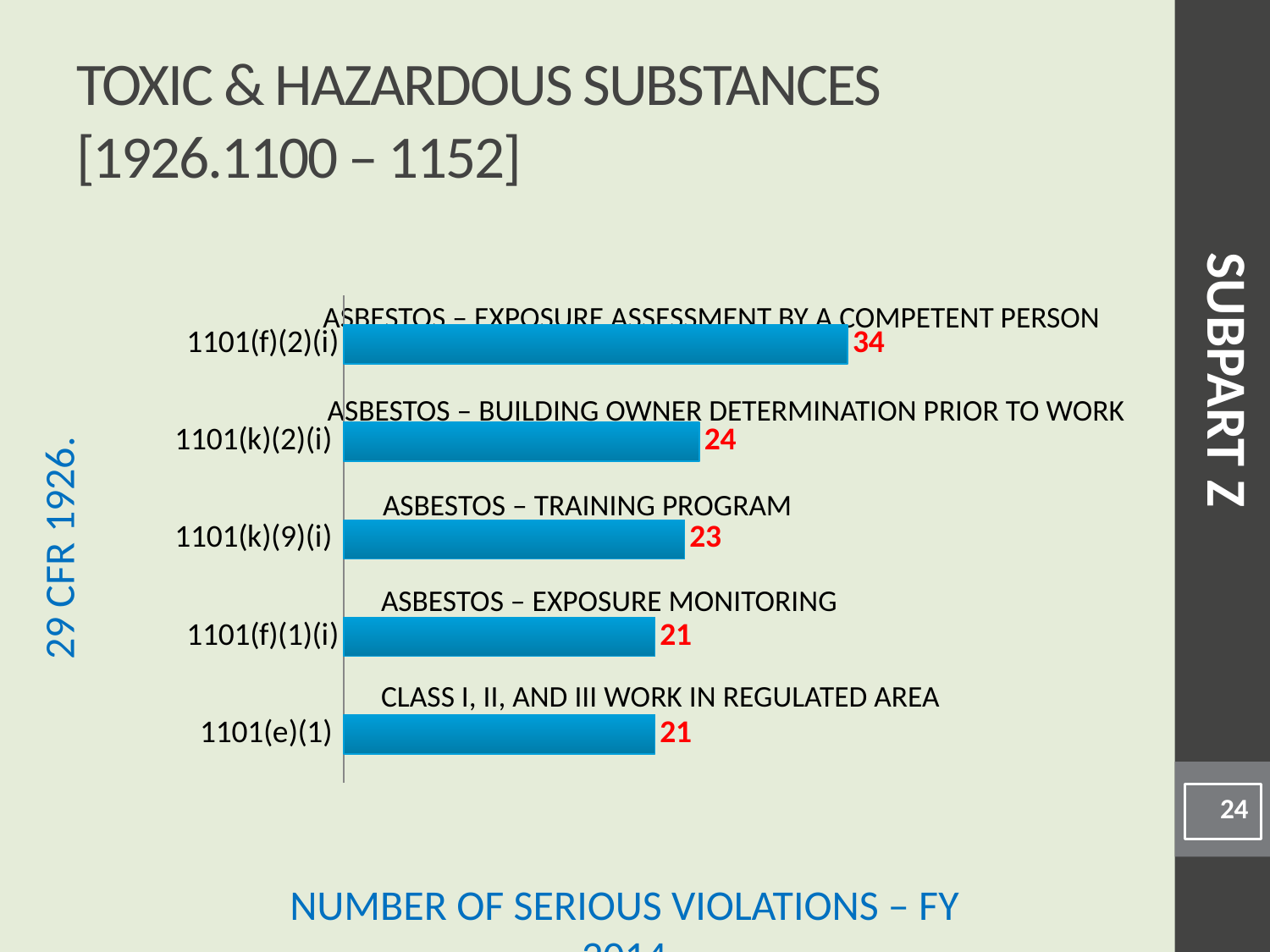
What is the number of serious violations for 1101(f)(2)(i)? 34 How many categories are shown in the chart? 5 Which is larger, the value for 1101(k)(2)(i) or the value for 1101(f)(1)(i)? 1101(k)(2)(i) What is the difference between the values for 1101(k)(9)(i) and 1101(f)(1)(i)? 2 What description is given for the bar labelled 1101(k)(9)(i)? ASBESTOS – TRAINING PROGRAM What is the number of serious violations for 1101(k)(9)(i)? 23 What is the difference between the values for 1101(f)(2)(i) and 1101(k)(2)(i)? 10 What is the number of serious violations for 1101(e)(1)? 21 What is the number of serious violations for 1101(k)(2)(i)? 24 What kind of chart is shown on the slide? Bar chart Which category has the highest number of serious violations? 1101(f)(2)(i) What is the total of all the values shown in the chart? 123